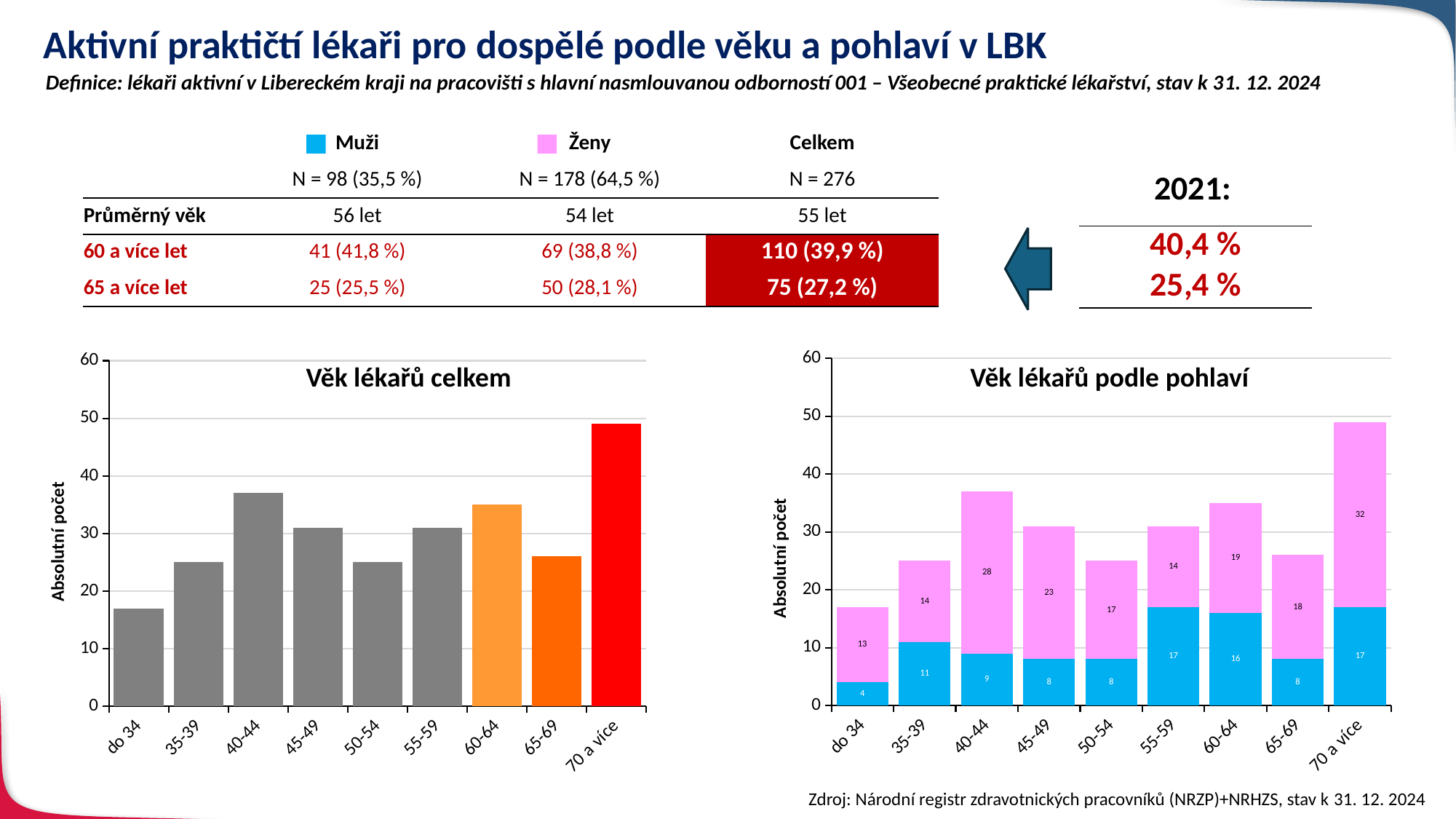
How many age categories are shown in the chart 'Věk lékařů celkem'? 9 In the chart 'Věk lékařů podle pohlaví', what is the total of the stacked bar for '40-44'? 37 In the chart 'Věk lékařů podle pohlaví', which age category has the lowest Muži value? do 34 In the chart 'Věk lékařů podle pohlaví', which age category has the highest Ženy value? 70 a více In the chart 'Věk lékařů podle pohlaví', what is the value for Ženy in the '70 a více' category? 32 In the chart 'Věk lékařů celkem', which age category has the lowest value? do 34 What kind of chart is 'Věk lékařů celkem'? bar chart In the chart 'Věk lékařů celkem', is the value for '70 a více' greater or less than 40? greater In the chart 'Věk lékařů podle pohlaví', what is the value for Muži in the 'do 34' category? 4 In the chart 'Věk lékařů podle pohlaví', is the Ženy value for '45-49' larger or the Ženy value for '50-54'? 45-49 In the chart 'Věk lékařů podle pohlaví', what is the difference between the Ženy and Muži values for '40-44'? 19